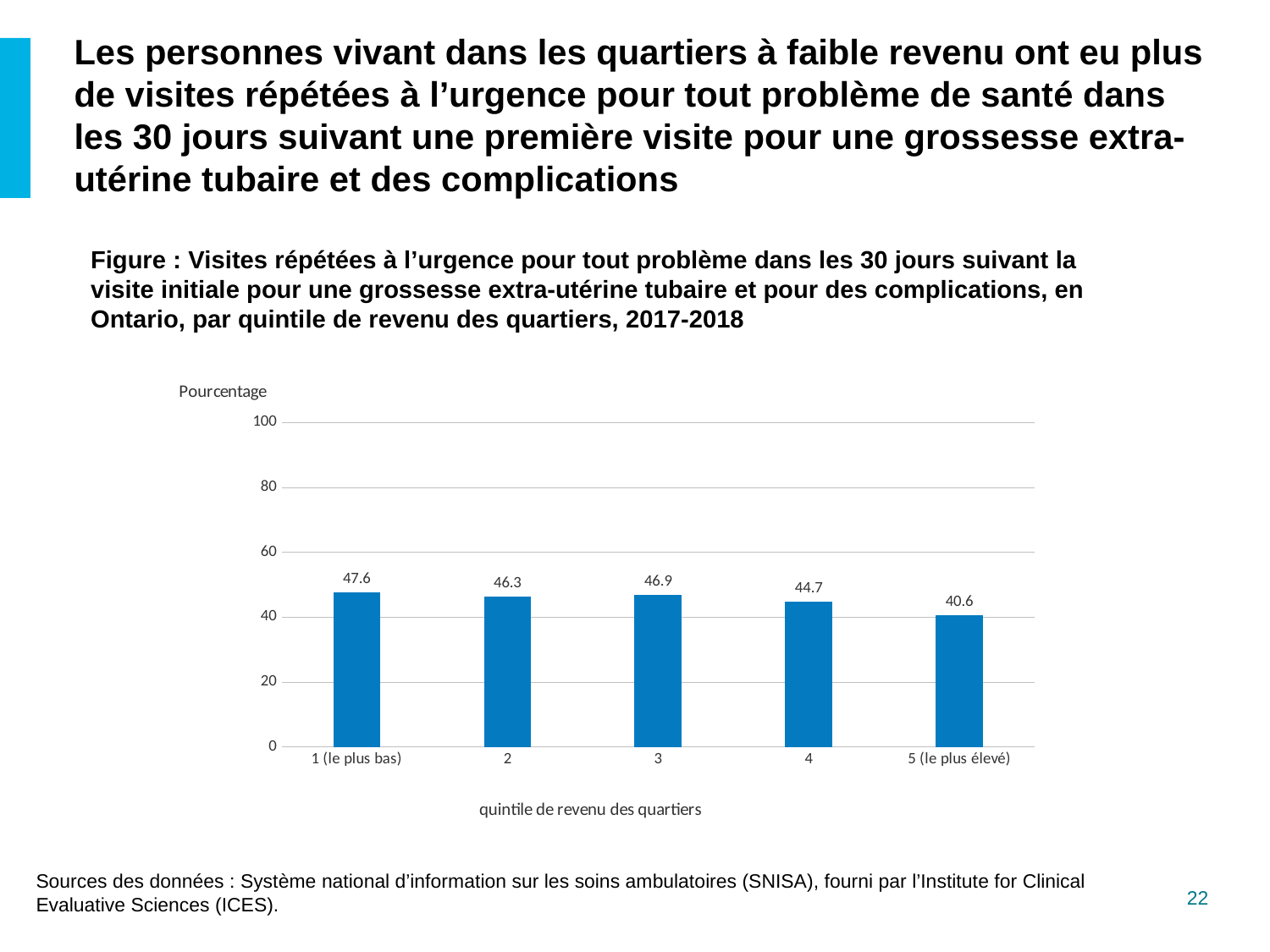
How many quintile categories are shown on the x axis? 5 What is the difference between the values for quintile 3 and quintile 4? 2.2 What is the value for quintile 5 (le plus élevé)? 40.6 Which quintile has the lowest value? 5 (le plus élevé) What kind of chart is shown? bar chart What is the label of the x axis? quintile de revenu des quartiers Which is larger, the value for quintile 2 or quintile 4? 2 What is the value for quintile 3? 46.9 What is the value for quintile 1 (le plus bas)? 47.6 What is the difference between the values for quintile 1 (le plus bas) and quintile 5 (le plus élevé)? 7.0 Is the value for quintile 4 greater or less than 40? greater Which quintile has the highest value? 1 (le plus bas)